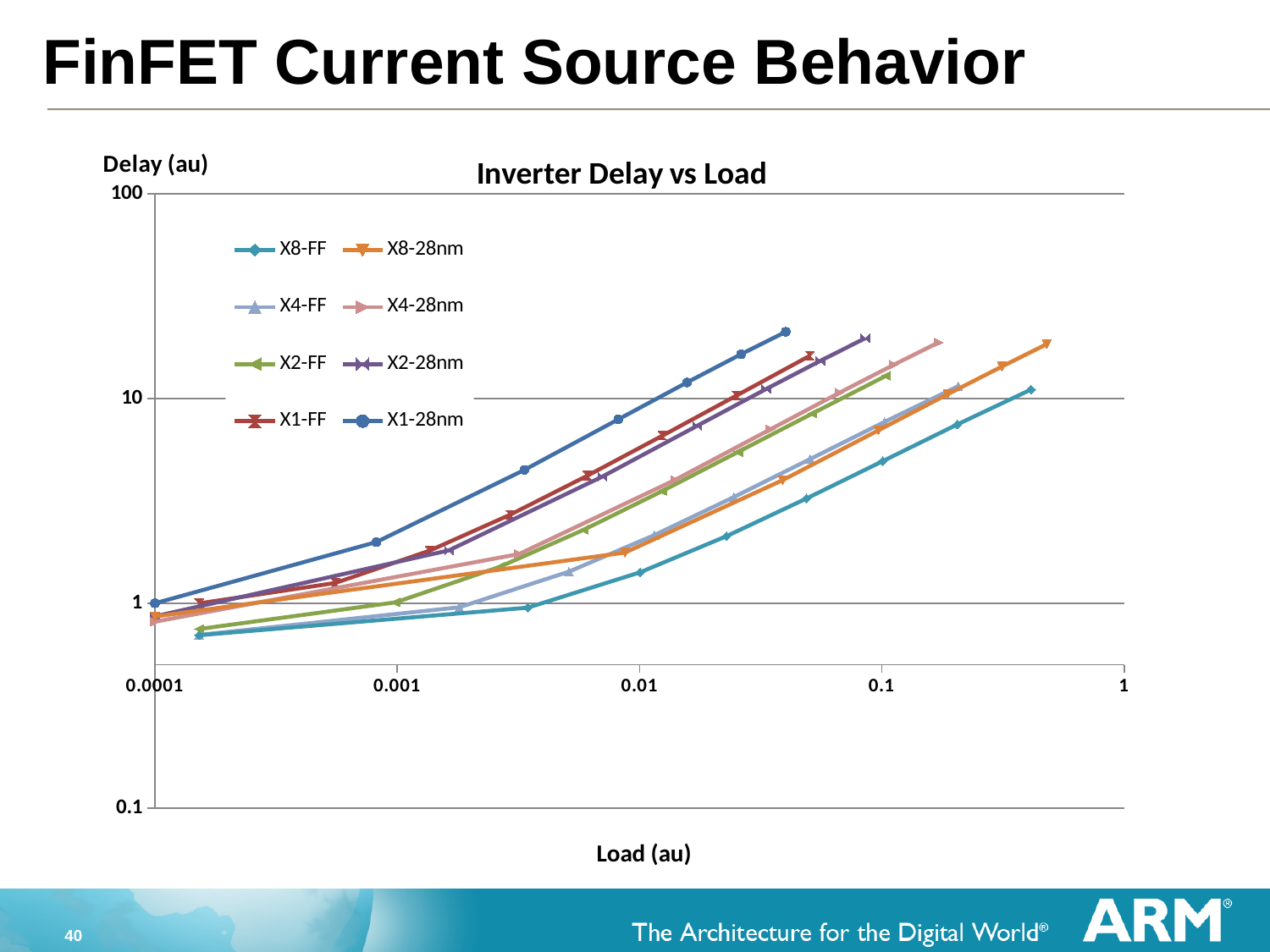
Is the delay for X8-FF at a load of 0.01 greater or less than 1? greater How many series does the legend of the chart list? 8 Do the delay values rise or fall as load increases along the x axis? Rise Is the highest delay value plotted for X8-28nm greater or less than 10? greater What is the title of the chart? Inverter Delay vs Load At a load of 0.01, which series has the larger delay, X1-28nm or X8-FF? X1-28nm What kind of chart is shown on the slide? Line chart Is the highest delay value plotted for X1-28nm greater or less than 10? greater What is the label of the x axis of the chart? Load (au) At a load of 0.001, which series has the larger delay, X1-28nm or X8-FF? X1-28nm